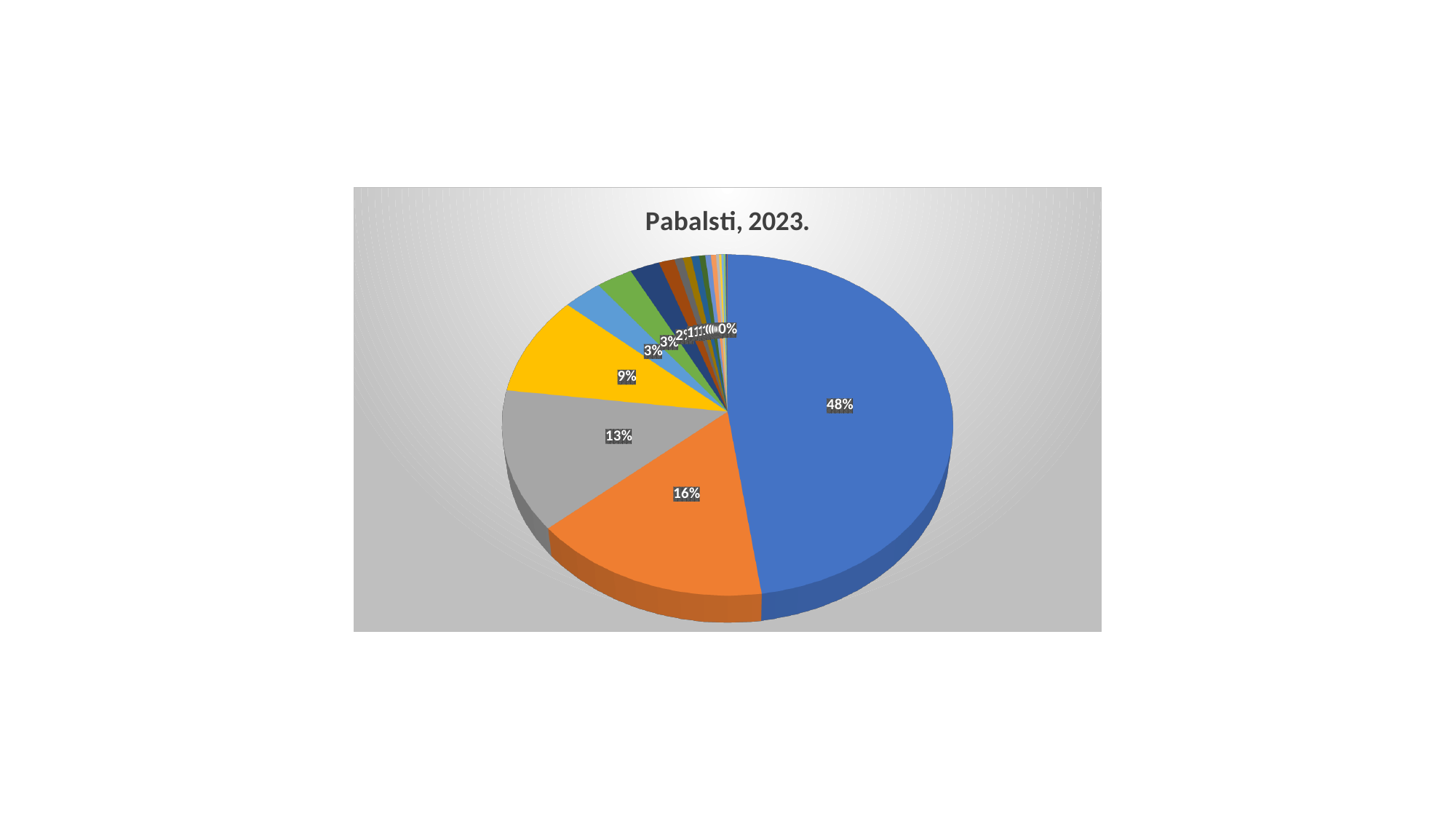
What percentage is shown on the yellow slice of the pie? 9% Is the share of the blue slice greater or less than 50%? less What is the title of the chart? Pabalsti, 2023. What percentage is shown on the orange slice of the pie? 16% What kind of chart is shown on the slide? Pie chart Which slice is the largest in the pie chart? The blue slice (48%) What share of the pie does the largest slice (blue) represent? 48% Does the chart include a legend identifying the slices? No Which is larger, the orange slice or the grey slice? The orange slice What percentage is shown on the grey slice of the pie? 13% What is the difference in percentage points between the grey slice (13%) and the yellow slice (9%)? 4 percentage points What is the difference in percentage points between the blue slice (48%) and the orange slice (16%)? 32 percentage points